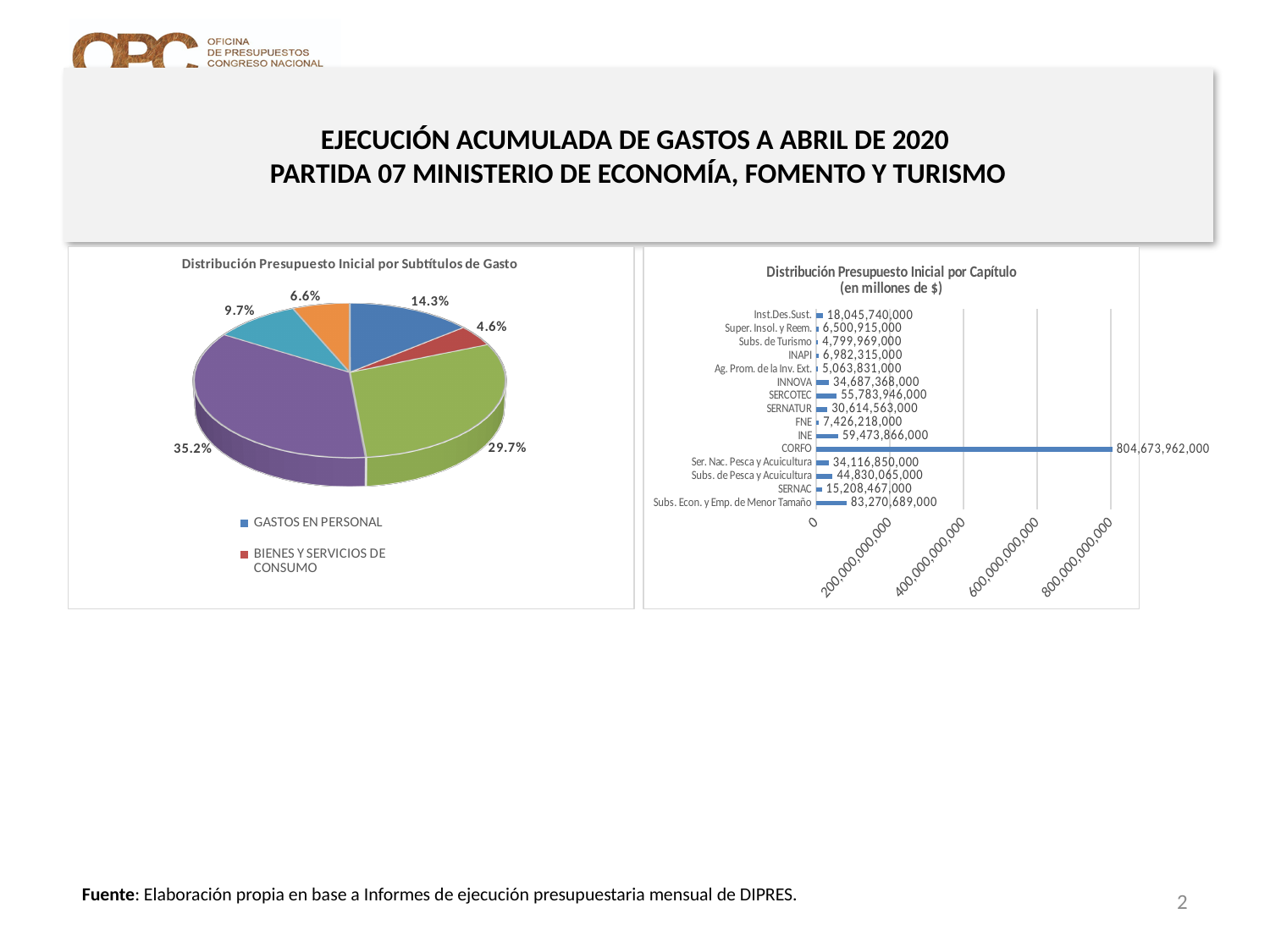
In the chart 'Distribución Presupuesto Inicial por Capítulo', what is the value for CORFO? 804,673,962,000 In the pie chart on the left, what is the largest percentage shown? 35.2% In the chart 'Distribución Presupuesto Inicial por Capítulo', which capítulo has the lowest value? Subs. de Turismo In the chart 'Distribución Presupuesto Inicial por Capítulo', which capítulo has the highest value? CORFO What kind of chart is 'Distribución Presupuesto Inicial por Capítulo'? Bar chart In the chart 'Distribución Presupuesto Inicial por Capítulo', what is the value for INE? 59,473,866,000 How many slices does the pie chart on the left have? 6 In the chart 'Distribución Presupuesto Inicial por Capítulo', what is the difference between INE and SERCOTEC? 3,689,920,000 How many capítulos are shown in the chart 'Distribución Presupuesto Inicial por Capítulo'? 15 In the pie chart 'Distribución Presupuesto Inicial por Subtítulos de Gasto', what share does BIENES Y SERVICIOS DE CONSUMO have? 4.6% In the pie chart 'Distribución Presupuesto Inicial por Subtítulos de Gasto', what share does GASTOS EN PERSONAL have? 14.3% In the chart 'Distribución Presupuesto Inicial por Capítulo', which is larger, SERNATUR or INNOVA? INNOVA